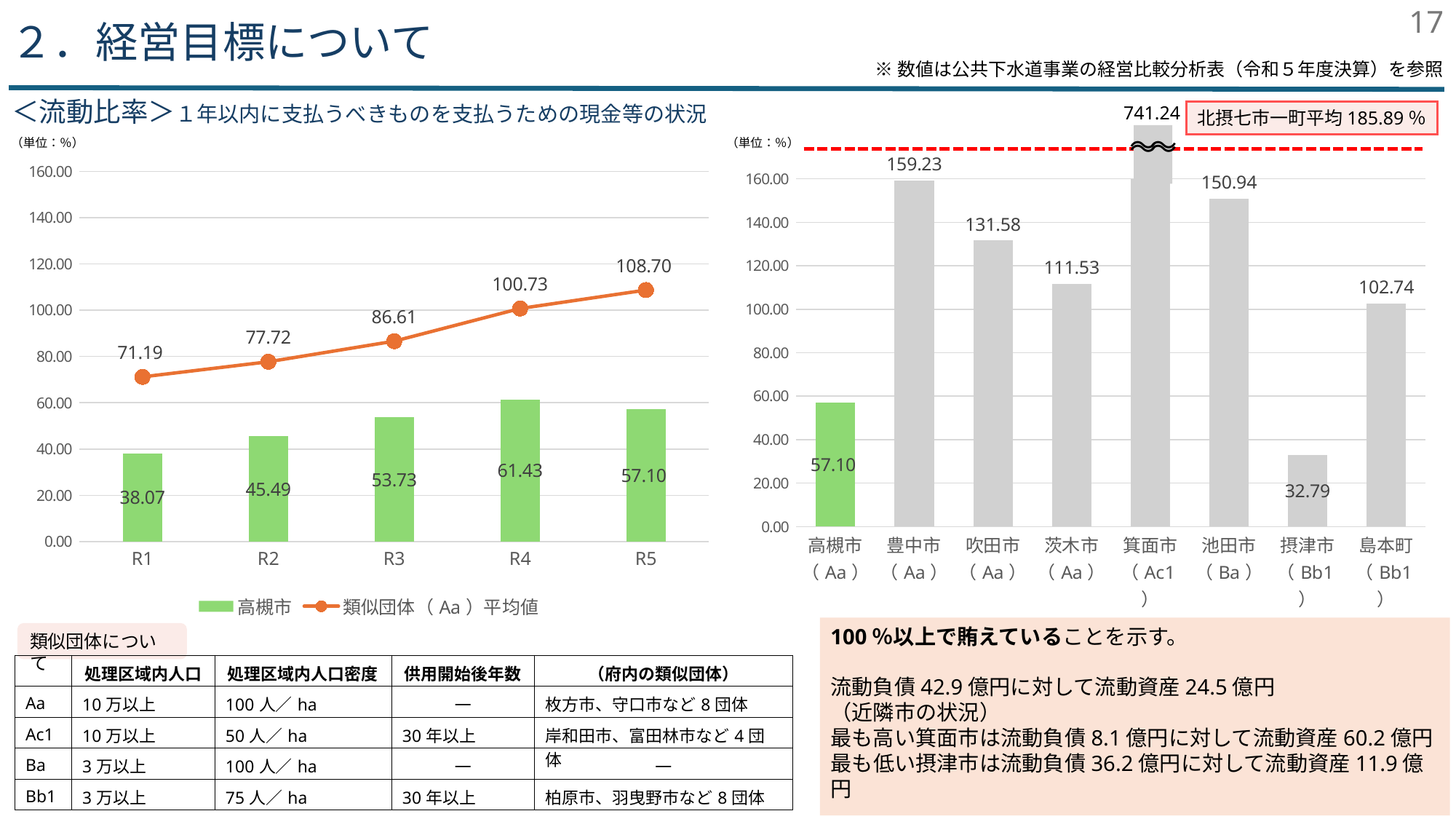
In the left chart, does the 類似団体（Aa）平均値 rise or fall from R1 to R5? rise In the left chart, what is the 類似団体（Aa）平均値 value in R5? 108.70 In the right chart, which is larger, the value for 豊中市 or 池田市? 豊中市 In the left chart, how many series does the legend list? 2 In the right chart, what is the value for 箕面市? 741.24 In the left chart, what is the value for 高槻市 in R3? 53.73 In the right chart, what is the difference between 吹田市 and 茨木市? 20.05 In the left chart, what is the difference between the 類似団体（Aa）平均値 and 高槻市 in R1? 33.12 What type of chart is the right chart? bar chart In the right chart, which municipality has the lowest value? 摂津市 In the right chart, how many municipalities are shown? 8 In the left chart, in which year is the 高槻市 value highest? R4